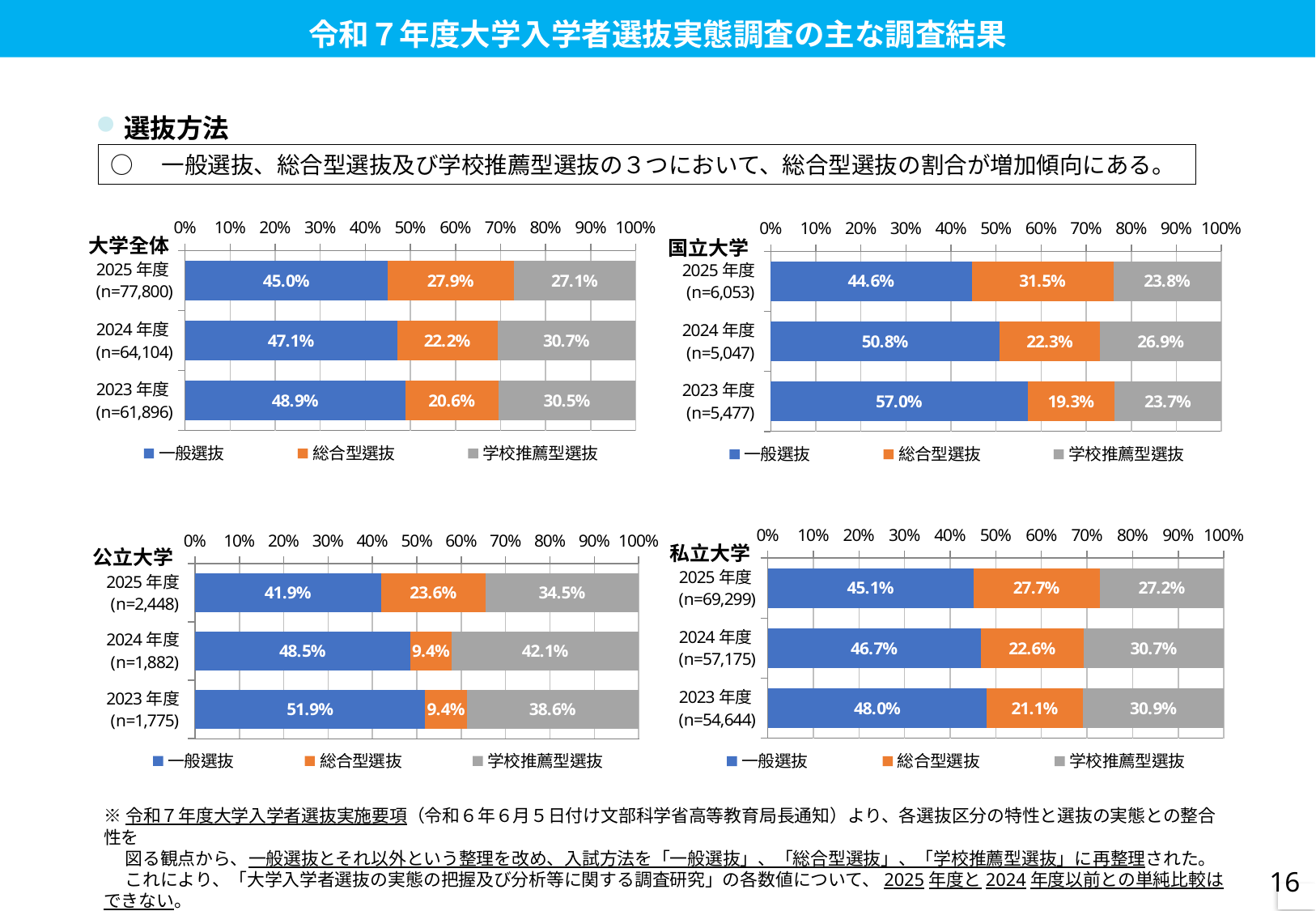
How many years (categories) are shown in the 国立大学 chart? 3 What kind of chart is the 大学全体 chart? Stacked bar chart In the 私立大学 chart, does the value for 総合型選抜 rise or fall from 2023 年度 to 2025 年度? Rise In the 大学全体 chart, what is the value for 一般選抜 in 2025 年度? 45.0% In the 私立大学 chart, what is the value for 一般選抜 in 2023 年度? 48.0% In the 国立大学 chart, which year has the highest value for 一般選抜? 2023 年度 In the 私立大学 chart, which is larger: 学校推薦型選抜 in 2024 年度 or 学校推薦型選抜 in 2025 年度? 2024 年度 How many series does the legend of the 公立大学 chart list? 3 In the 国立大学 chart, what is the value for 総合型選抜 in 2025 年度? 31.5% In the 大学全体 chart, what is the difference between the 総合型選抜 values for 2025 年度 and 2023 年度? 7.3% In the 公立大学 chart, which year has the lowest value for 総合型選抜? 2023 年度 and 2024 年度 (both 9.4%) In the 公立大学 chart, what is the value for 学校推薦型選抜 in 2024 年度? 42.1%